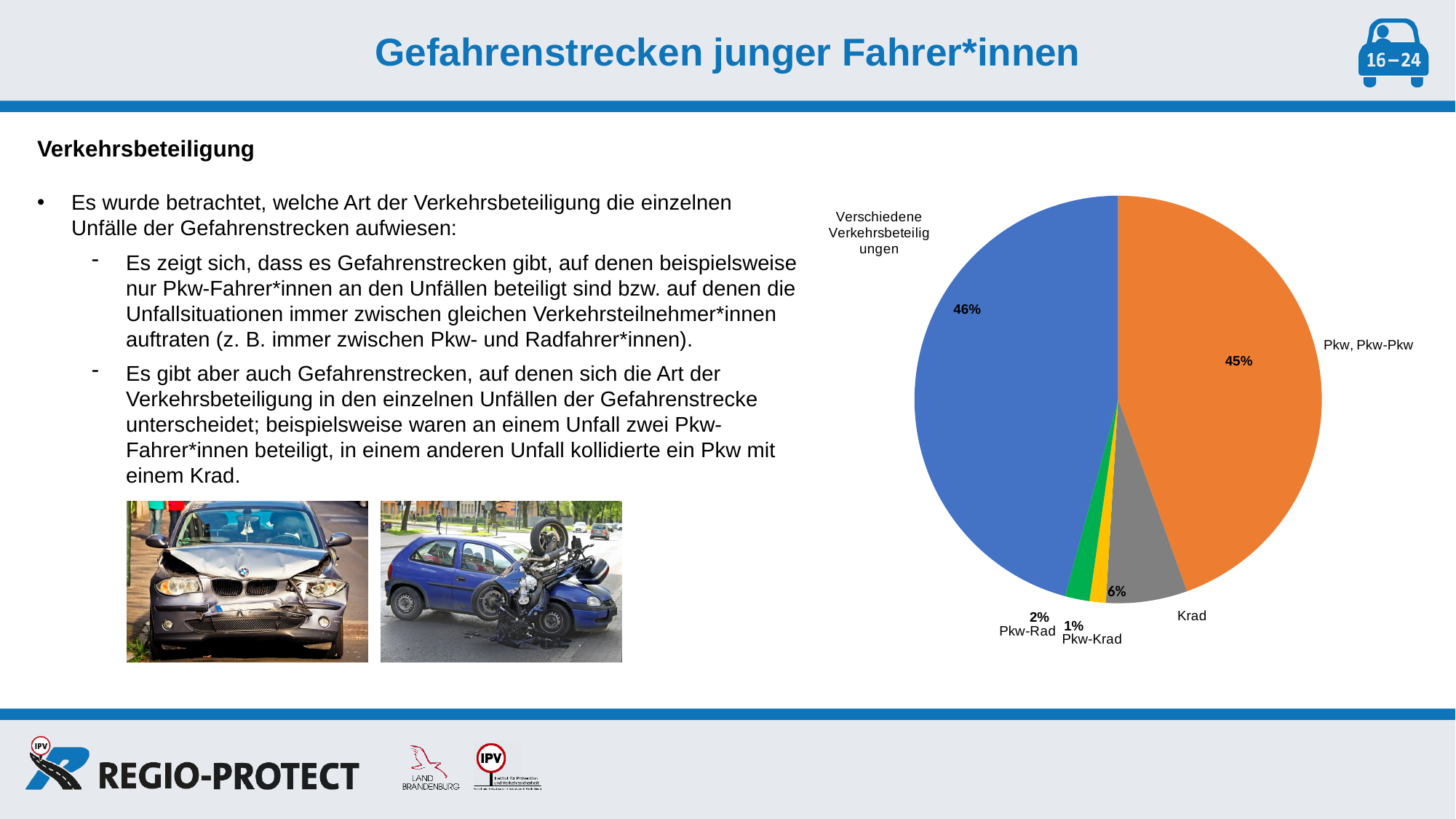
How many slices does the pie chart have? 5 What colour is the 'Pkw, Pkw-Pkw' slice in the pie chart? orange What kind of chart is shown on the slide? pie chart What share of the pie does the slice 'Krad' have? 6% Which slice of the pie chart is the largest? Verschiedene Verkehrsbeteiligungen Which slice is larger, 'Krad' or 'Pkw-Rad'? Krad What share of the pie does the slice 'Pkw, Pkw-Pkw' have? 45% What share of the pie does the slice 'Pkw-Rad' have? 2% Which slice of the pie chart is the smallest? Pkw-Krad What share of the pie does the slice 'Verschiedene Verkehrsbeteiligungen' have? 46% What share of the pie does the slice 'Pkw-Krad' have? 1% What is the difference in percentage points between the 'Pkw, Pkw-Pkw' slice and the 'Krad' slice? 39 percentage points